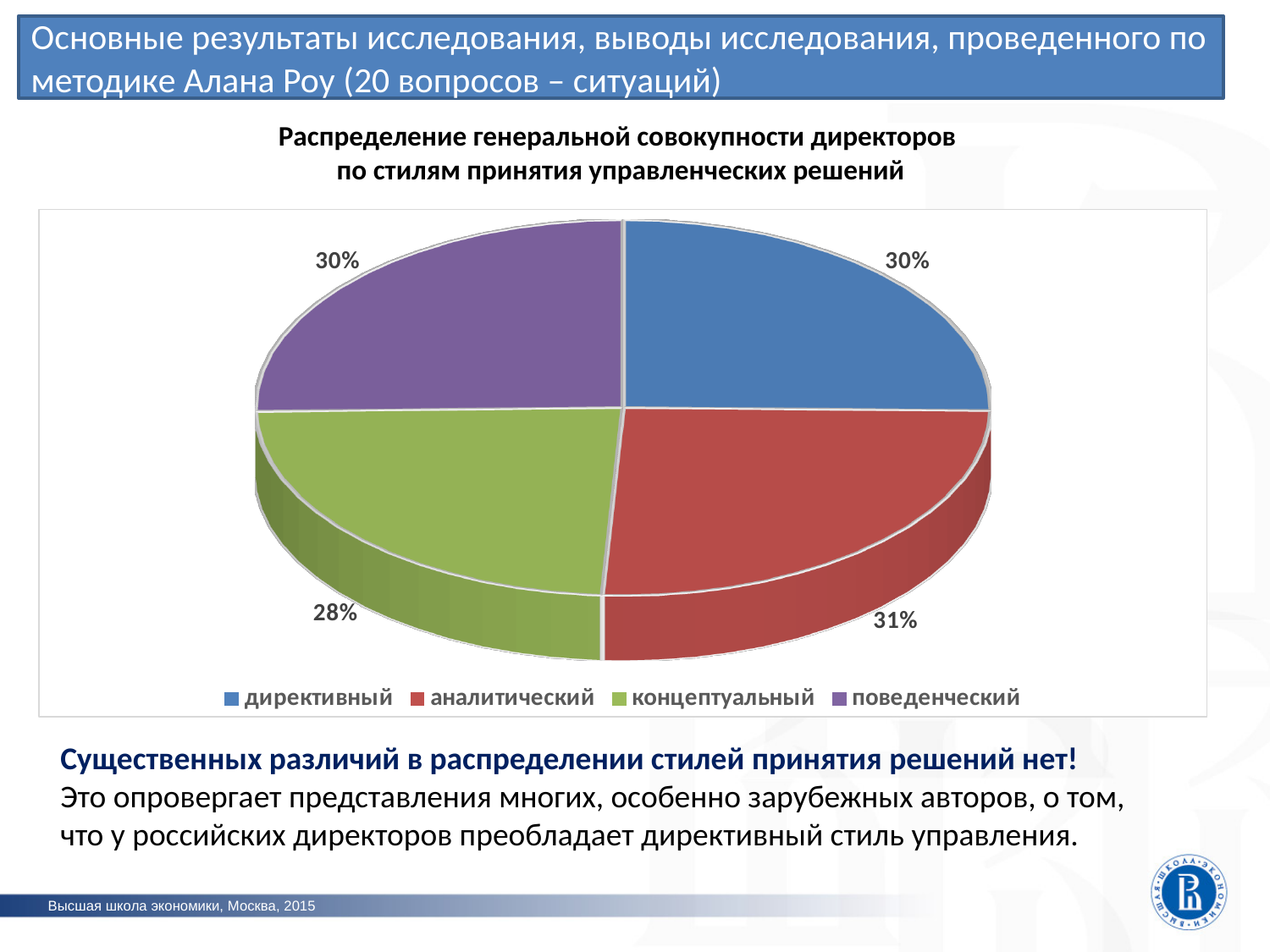
Which decision-making style has the smallest share of directors? концептуальный Which has a larger share: аналитический or концептуальный? аналитический What share of directors has the директивный decision-making style? 30% What share of directors has the поведенческий decision-making style? 30% What is the title of the chart? Распределение генеральной совокупности директоров по стилям принятия управленческих решений Which colour represents the аналитический style in the chart? Red How many decision-making styles are shown in the pie chart? 4 What share of directors has the аналитический decision-making style? 31% What type of chart is shown on the slide? Pie chart Which decision-making style has the largest share of directors? аналитический What share of directors has the концептуальный decision-making style? 28% What is the difference in percentage points between the аналитический and концептуальный shares? 3 percentage points